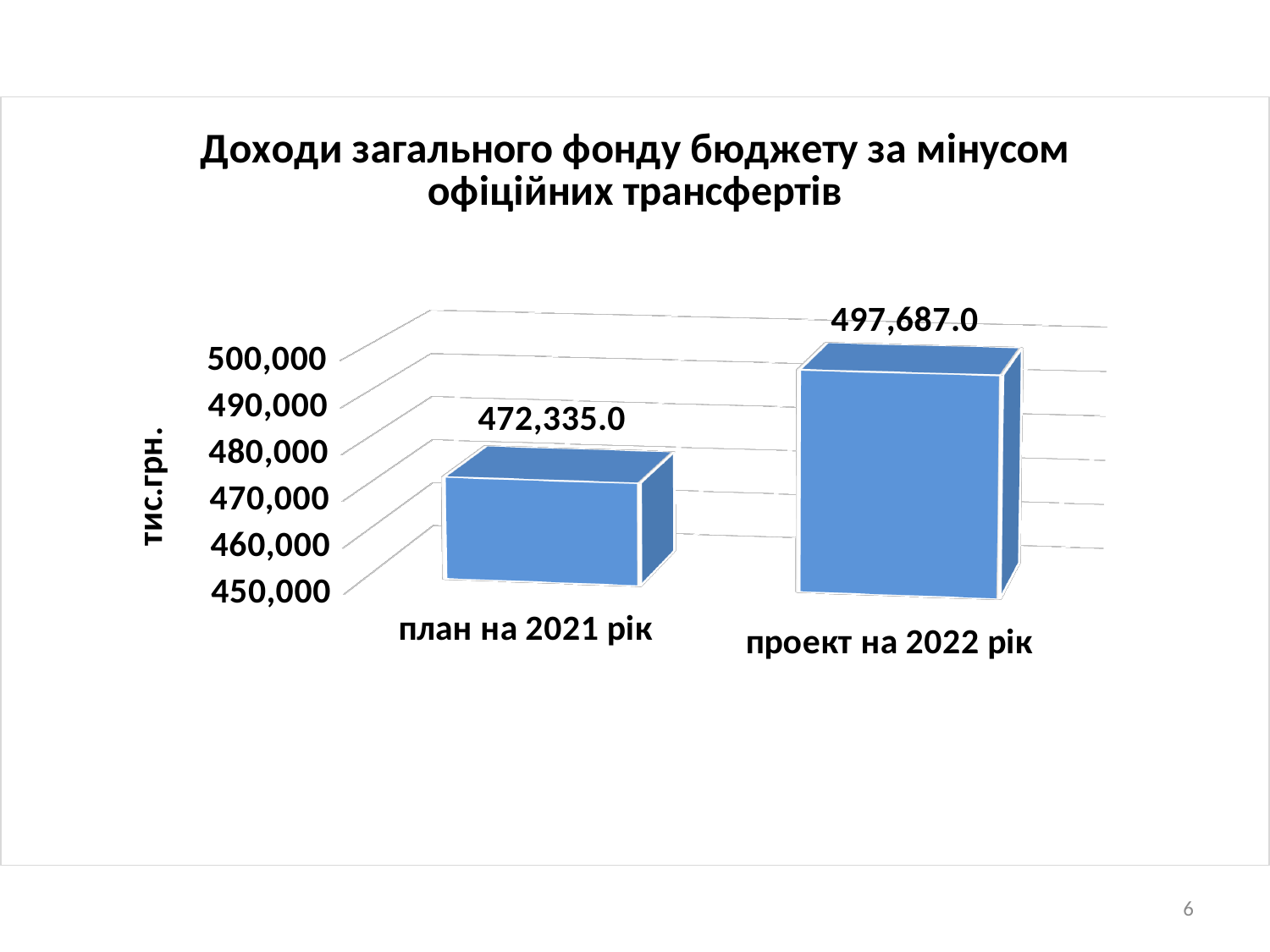
Which is larger: the value for план на 2021 рік or the value for проект на 2022 рік? проект на 2022 рік What kind of chart is shown on the slide? bar chart Which category has the highest value? проект на 2022 рік Is the value for план на 2021 рік greater or less than 480,000? less Do the values rise or fall from план на 2021 рік to проект на 2022 рік? rise Is the value for проект на 2022 рік greater or less than 490,000? greater Which category has the lowest value? план на 2021 рік What is the value for план на 2021 рік? 472,335.0 How many categories are shown in the chart? 2 What is the value for проект на 2022 рік? 497,687.0 What is the label on the vertical axis of the chart? тис.грн. What is the difference between the value for проект на 2022 рік and the value for план на 2021 рік? 25,352.0